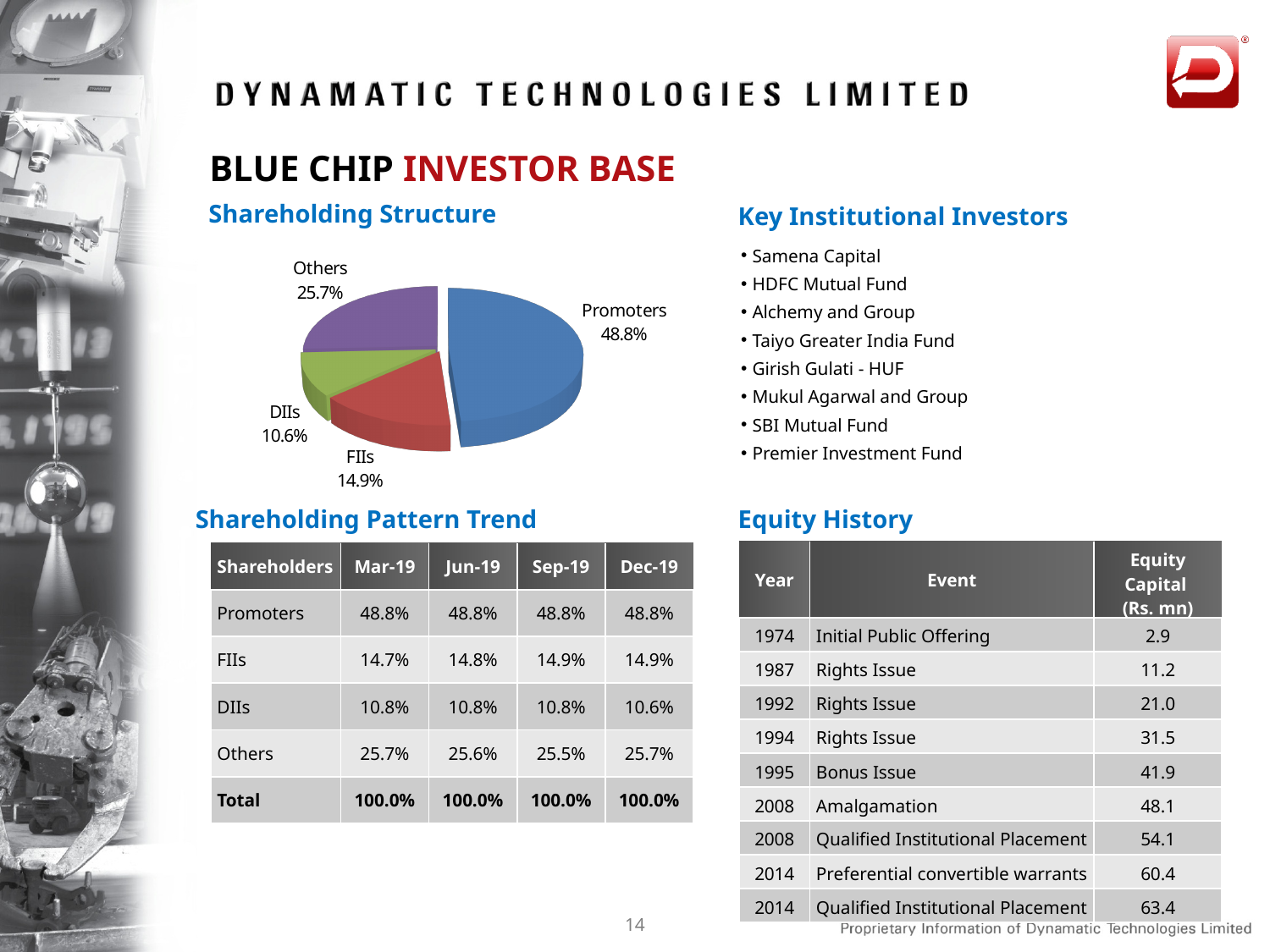
What is the value shown for FIIs in the Shareholding Structure pie chart? 14.9% What is the difference in percentage points between the Promoters and Others slices in the Shareholding Structure pie chart? 23.1 What share of the Shareholding Structure pie do Promoters hold? 48.8% How many slices does the Shareholding Structure pie chart have? 4 In the Shareholding Structure pie chart, which is larger: the FIIs slice or the Others slice? Others What colour is the Promoters slice in the Shareholding Structure pie chart? Blue What is the value shown for DIIs in the Shareholding Structure pie chart? 10.6% What kind of chart is shown under Shareholding Structure? Pie chart What is the difference in percentage points between the FIIs and DIIs slices in the Shareholding Structure pie chart? 4.3 What is the value shown for Others in the Shareholding Structure pie chart? 25.7% Which category has the largest slice in the Shareholding Structure pie chart? Promoters Which category has the smallest slice in the Shareholding Structure pie chart? DIIs